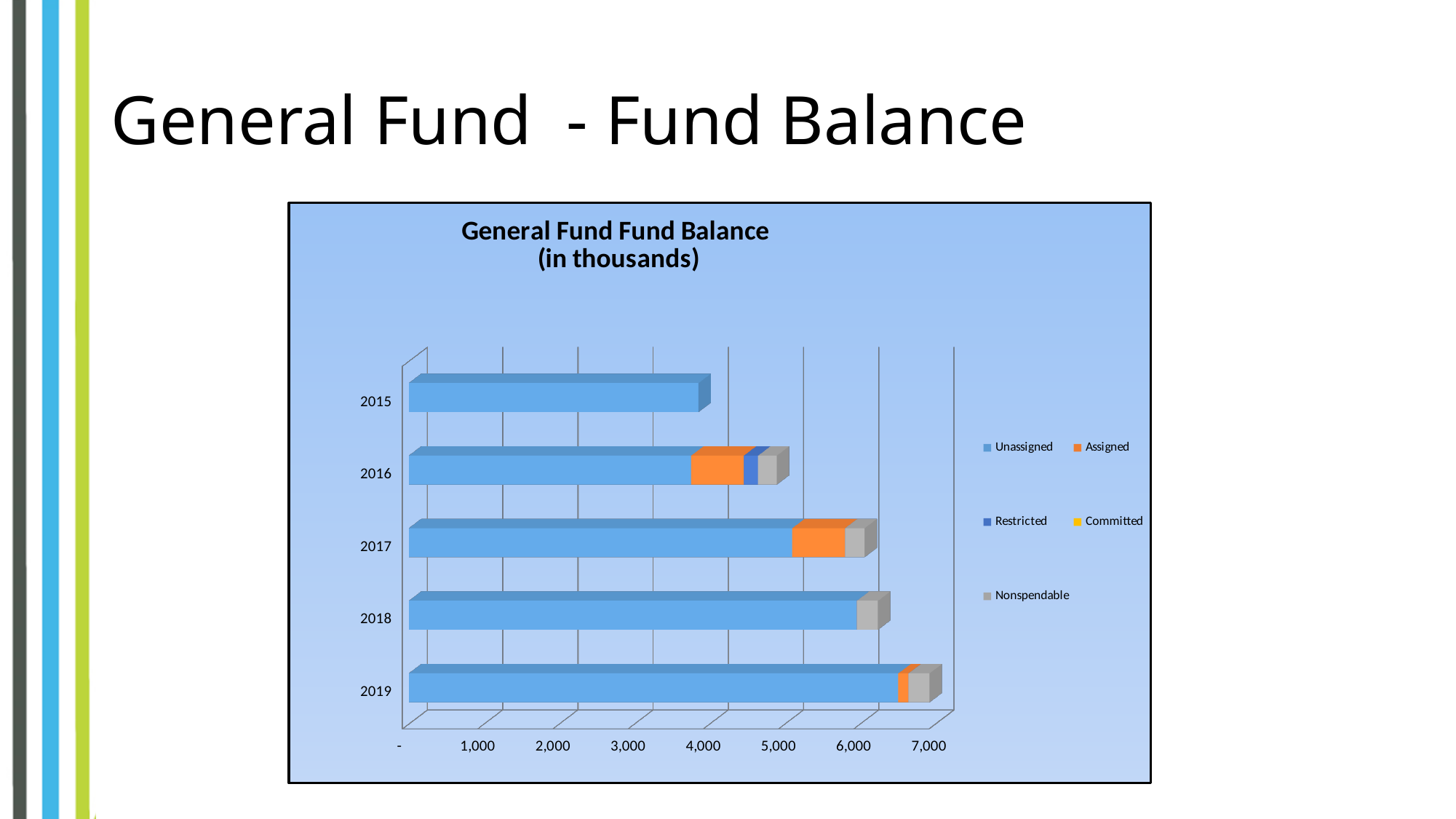
What is the title of the chart? General Fund Fund Balance (in thousands) Is the total fund balance for 2015 greater or less than 3,000? greater What kind of chart is shown on the slide? bar chart How many years are shown on the chart? 5 Is the total fund balance for 2019 greater or less than 6,000? greater Does the total fund balance generally rise or fall from 2015 to 2019? rise Which year has the smallest total fund balance? 2015 Which series is shown in orange in the legend? Assigned How many series does the legend list? 5 Is the Unassigned value for 2019 greater or less than 6,000? greater Which year has the larger total fund balance, 2016 or 2017? 2017 Which year has the largest total fund balance? 2019